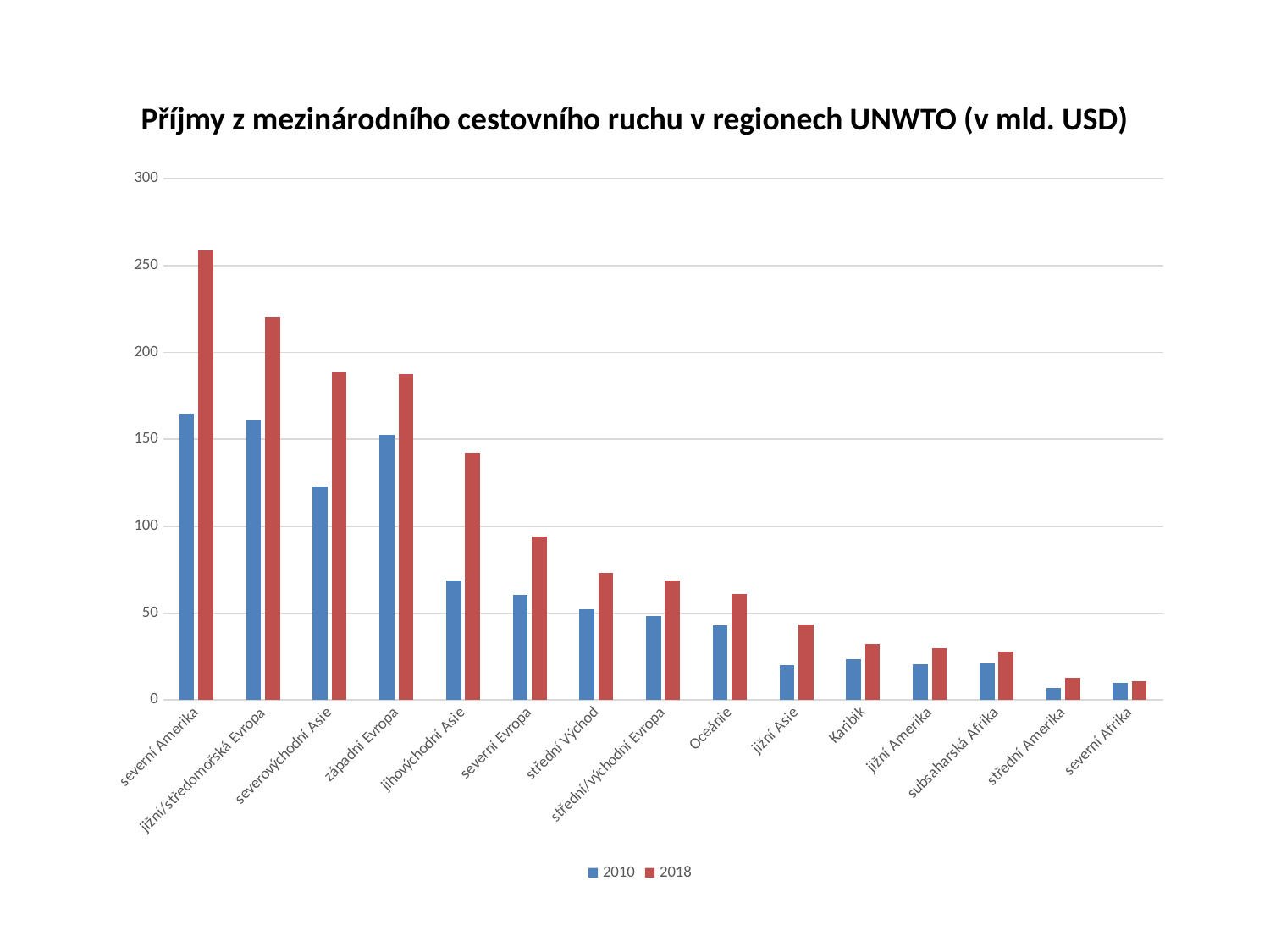
How many regions are shown on the x axis? 15 Is the 2018 value for severní Evropa greater or less than 100? less Do the 2018 values generally rise or fall from left to right along the x axis? fall Is the 2018 value for severní Amerika greater or less than 250? greater Which region has the highest value for 2018? severní Amerika How many series does the legend list? 2 What is the title of the chart? Příjmy z mezinárodního cestovního ruchu v regionech UNWTO (v mld. USD) Is the 2018 value for jižní/středomořská Evropa greater or less than 200? greater Which is larger for jihovýchodní Asie: the 2010 value or the 2018 value? 2018 What kind of chart is shown on the slide? bar chart